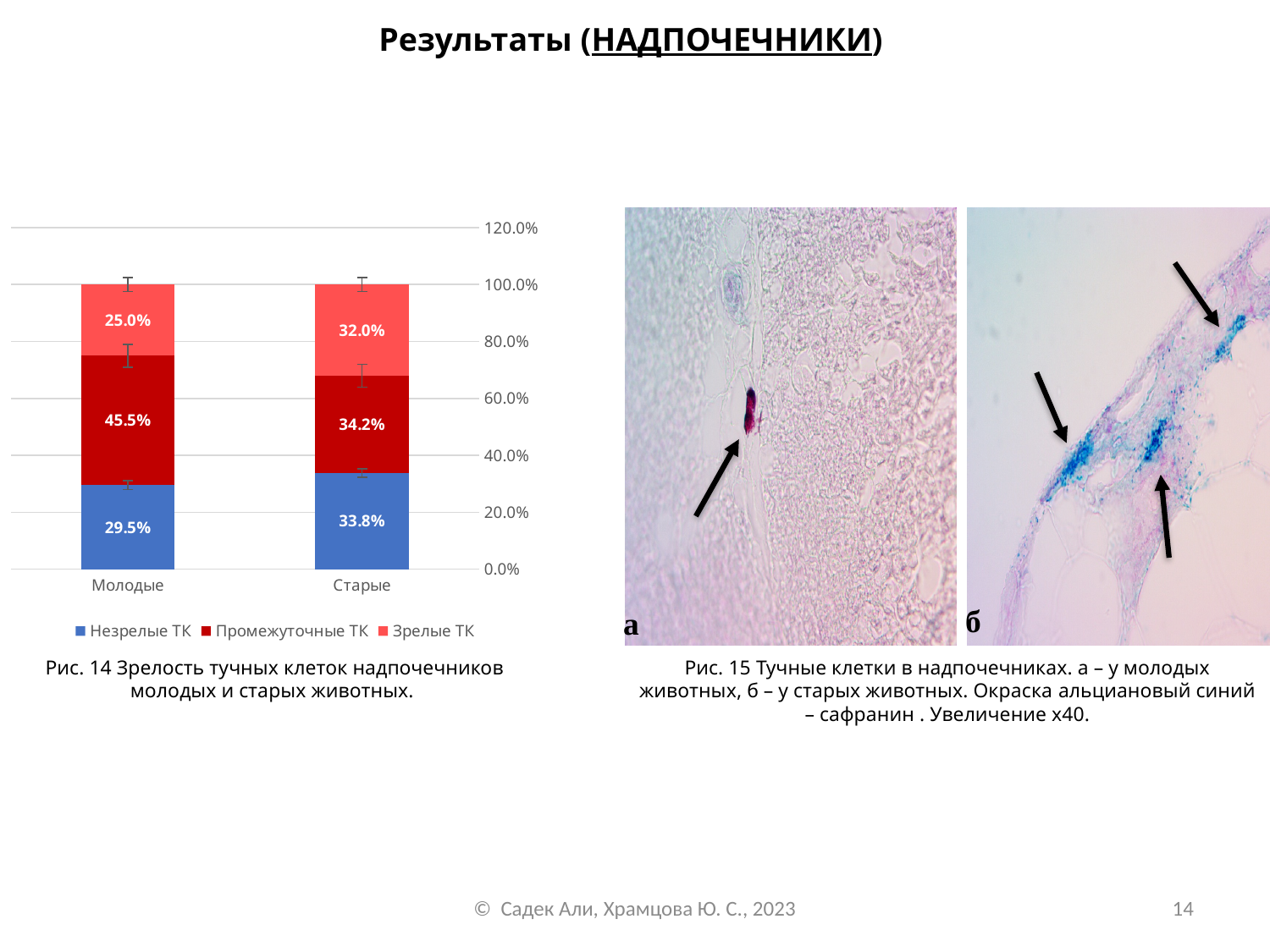
Which series is shown in blue in the legend? Незрелые ТК What is the difference between the Промежуточные ТК values for Молодые and Старые? 11.3% What is the value of Зрелые ТК for Старые? 32.0% What kind of chart is shown on the slide? Stacked bar chart What is the value of Промежуточные ТК for Старые? 34.2% How many categories are shown on the x axis? 2 What is the value of Зрелые ТК for Молодые? 25.0% Which category has the higher value for Промежуточные ТК? Молодые What is the value of Незрелые ТК for Молодые? 29.5% What is the total of the stacked bar for Молодые? 100.0% What is the difference between the Зрелые ТК values for Старые and Молодые? 7.0% How many series does the legend list? 3